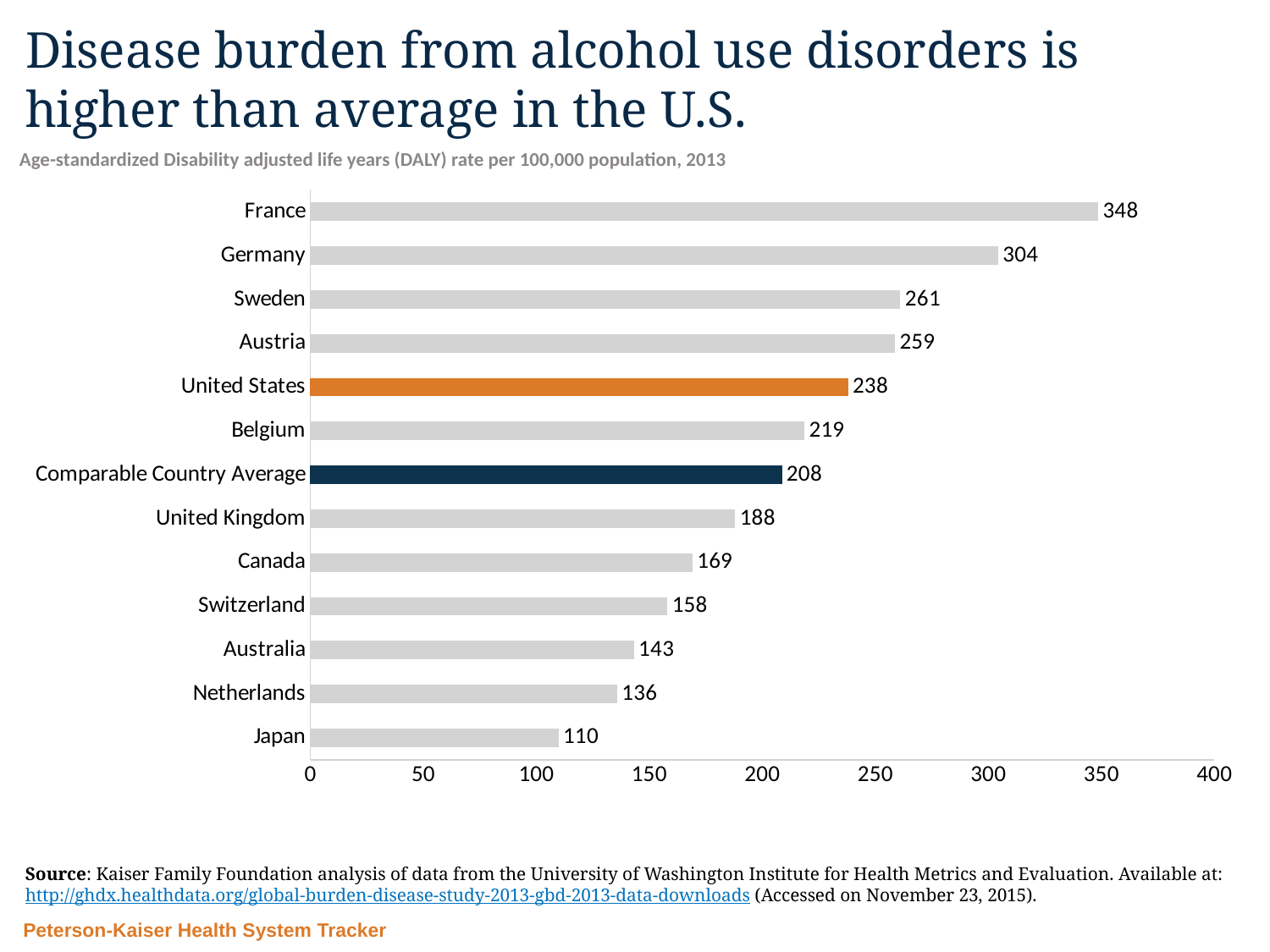
Which country has the lowest DALY rate in the chart? Japan What kind of chart is shown on the slide? Bar chart Which has a higher DALY rate, Canada or Switzerland? Canada What is the difference between France's and Germany's values? 44 What is the value shown for the Netherlands? 136 How many bars are shown in the chart? 13 Is the value for Belgium greater or less than 200? greater Which bar is coloured orange in the chart? United States What is the difference between the United States value and the Comparable Country Average? 30 What is the DALY rate for the United States? 238 What is the value shown for the Comparable Country Average? 208 Which country has the highest DALY rate in the chart? France